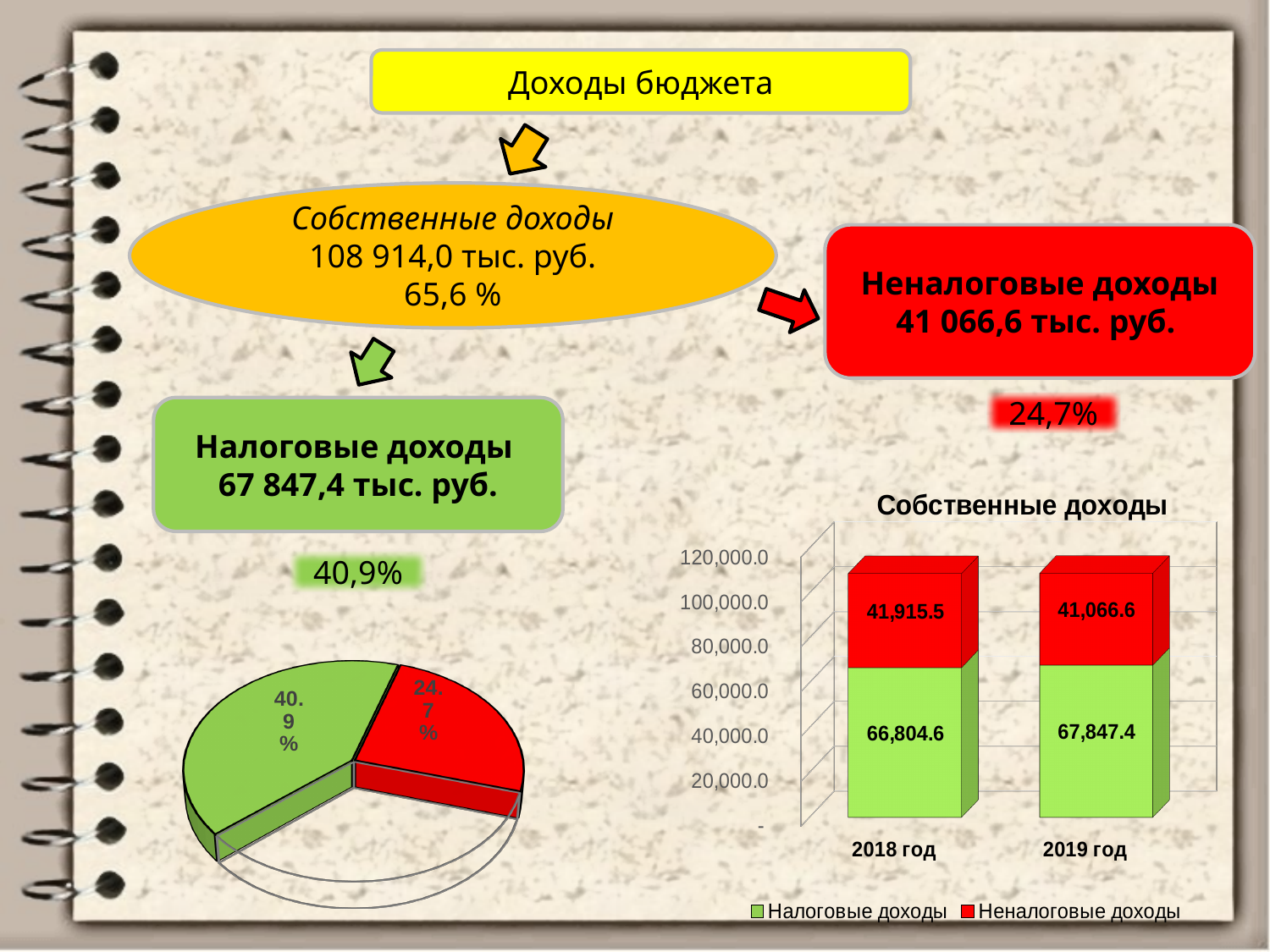
In the bar chart titled 'Собственные доходы', how many categories are shown on the x axis? 2 In the bar chart titled 'Собственные доходы', what is the total of the stacked bar for 2019 год? 108,914.0 In the bar chart titled 'Собственные доходы', what is the value of Неналоговые доходы for 2019 год? 41,066.6 In the bar chart titled 'Собственные доходы', which year has the larger value for Неналоговые доходы, 2018 год or 2019 год? 2018 год In the bar chart titled 'Собственные доходы', what is the value of Налоговые доходы for 2018 год? 66,804.6 In the bar chart titled 'Собственные доходы', what is the value of Неналоговые доходы for 2018 год? 41,915.5 In the bar chart titled 'Собственные доходы', how many series does the legend list? 2 In the bar chart titled 'Собственные доходы', what is the difference between Налоговые доходы in 2019 год and in 2018 год? 1,042.8 In the bar chart titled 'Собственные доходы', what is the total of the stacked bar for 2018 год? 108,720.1 In the bar chart titled 'Собственные доходы', what is the value of Налоговые доходы for 2019 год? 67,847.4 What kind of chart is the chart in the bottom-left of the slide? Pie chart In the pie chart in the bottom-left of the slide, what percentage is shown on the green slice? 40.9%